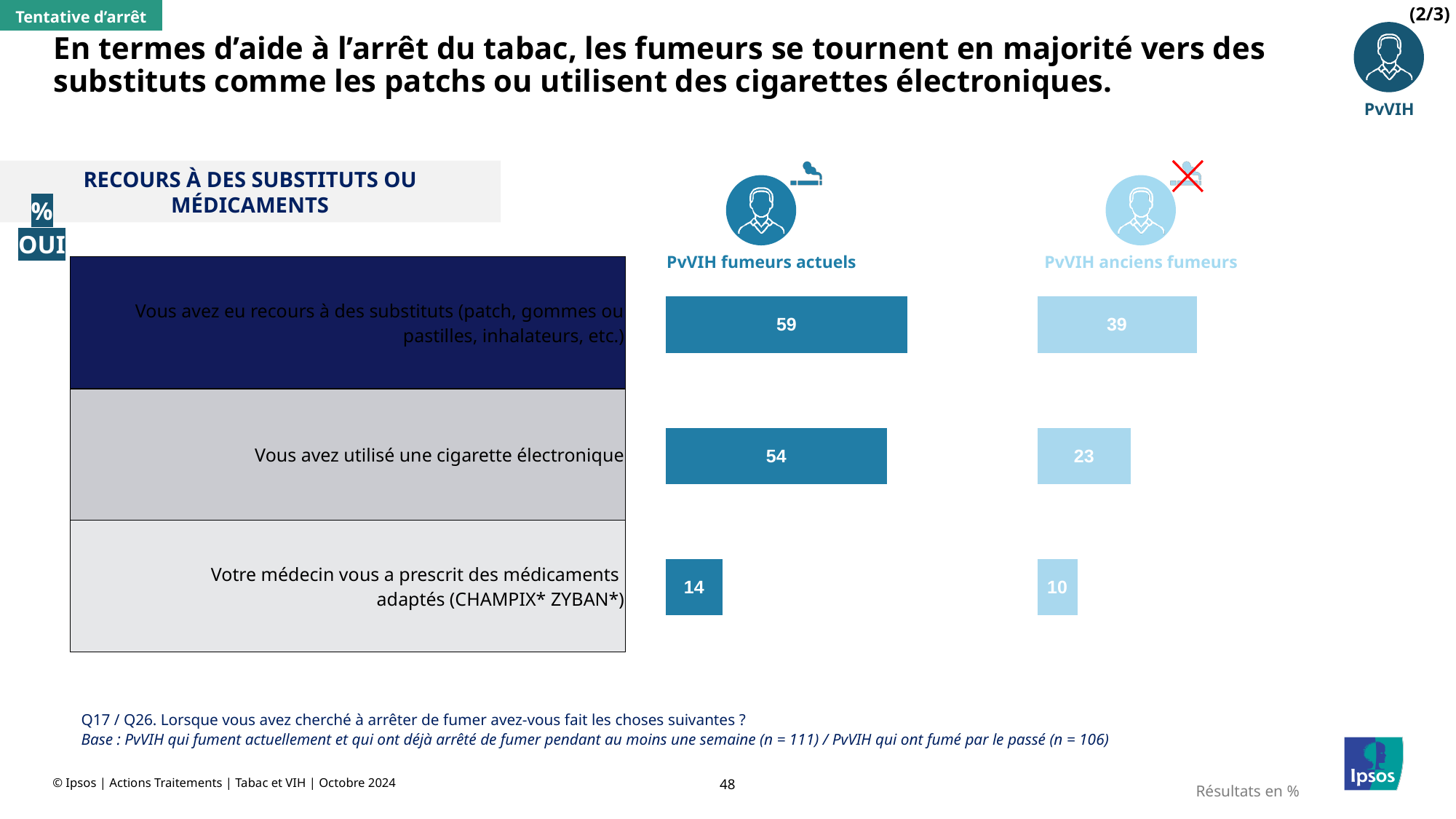
In the PvVIH fumeurs actuels chart, what is the value for 'Vous avez eu recours à des substituts (patch, gommes ou pastilles, inhalateurs, etc.)'? 59 How many categories are shown in the PvVIH fumeurs actuels chart? 3 What kind of chart is used to show the PvVIH anciens fumeurs results? Bar chart In the PvVIH anciens fumeurs chart, which category has the lowest value? Votre médecin vous a prescrit des médicaments adaptés (CHAMPIX* ZYBAN*) For 'Vous avez eu recours à des substituts', which group has the larger value: PvVIH fumeurs actuels or PvVIH anciens fumeurs? PvVIH fumeurs actuels In the PvVIH anciens fumeurs chart, what is the value for 'Vous avez utilisé une cigarette électronique'? 23 What is the title of the section containing the charts on the left of the slide? RECOURS À DES SUBSTITUTS OU MÉDICAMENTS In the PvVIH fumeurs actuels chart, which category has the highest value? Vous avez eu recours à des substituts (patch, gommes ou pastilles, inhalateurs, etc.) In the PvVIH fumeurs actuels chart, what is the difference between 'Vous avez eu recours à des substituts' and 'Votre médecin vous a prescrit des médicaments adaptés'? 45 In the PvVIH anciens fumeurs chart, what is the value for 'Vous avez eu recours à des substituts (patch, gommes ou pastilles, inhalateurs, etc.)'? 39 In the PvVIH fumeurs actuels chart, what is the value for 'Votre médecin vous a prescrit des médicaments adaptés (CHAMPIX* ZYBAN*)'? 14 What is the difference between the PvVIH fumeurs actuels and PvVIH anciens fumeurs values for 'Vous avez utilisé une cigarette électronique'? 31